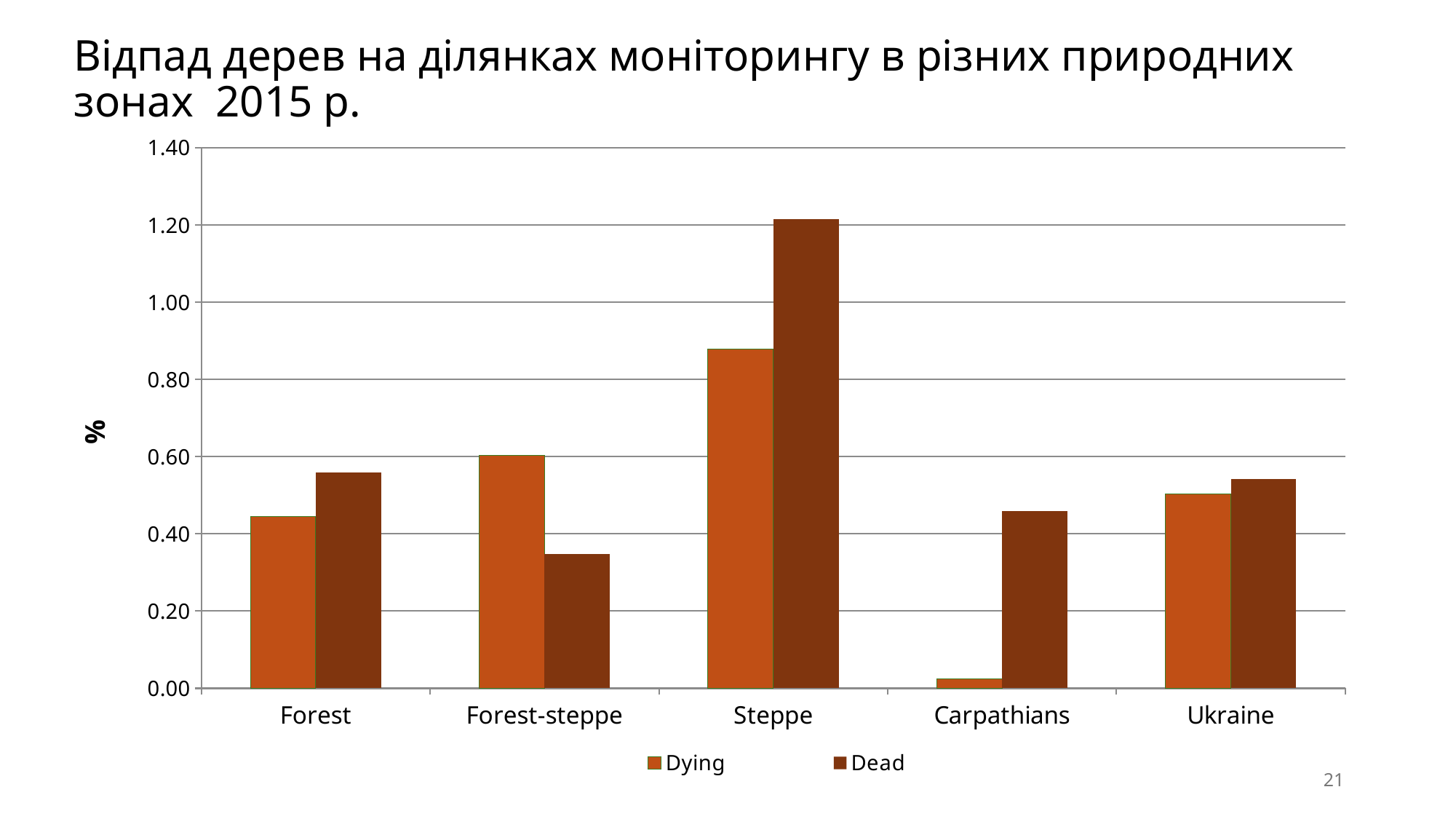
Is the Dead value for Forest-steppe greater or less than 0.40? less What kind of chart is shown on the slide? Bar chart Which category has the lowest Dying value? Carpathians How many series does the chart's legend list? 2 Is the Dead value for Steppe greater or less than 1.00? greater Is the Dying value for Carpathians greater or less than 0.20? less What is the label on the vertical axis of the chart? % Which category has the lowest Dead value? Forest-steppe Which category has the highest Dying value? Steppe How many categories are shown on the x axis of the chart? 5 For Forest-steppe, which is larger, the Dying value or the Dead value? Dying Which category has the highest Dead value? Steppe